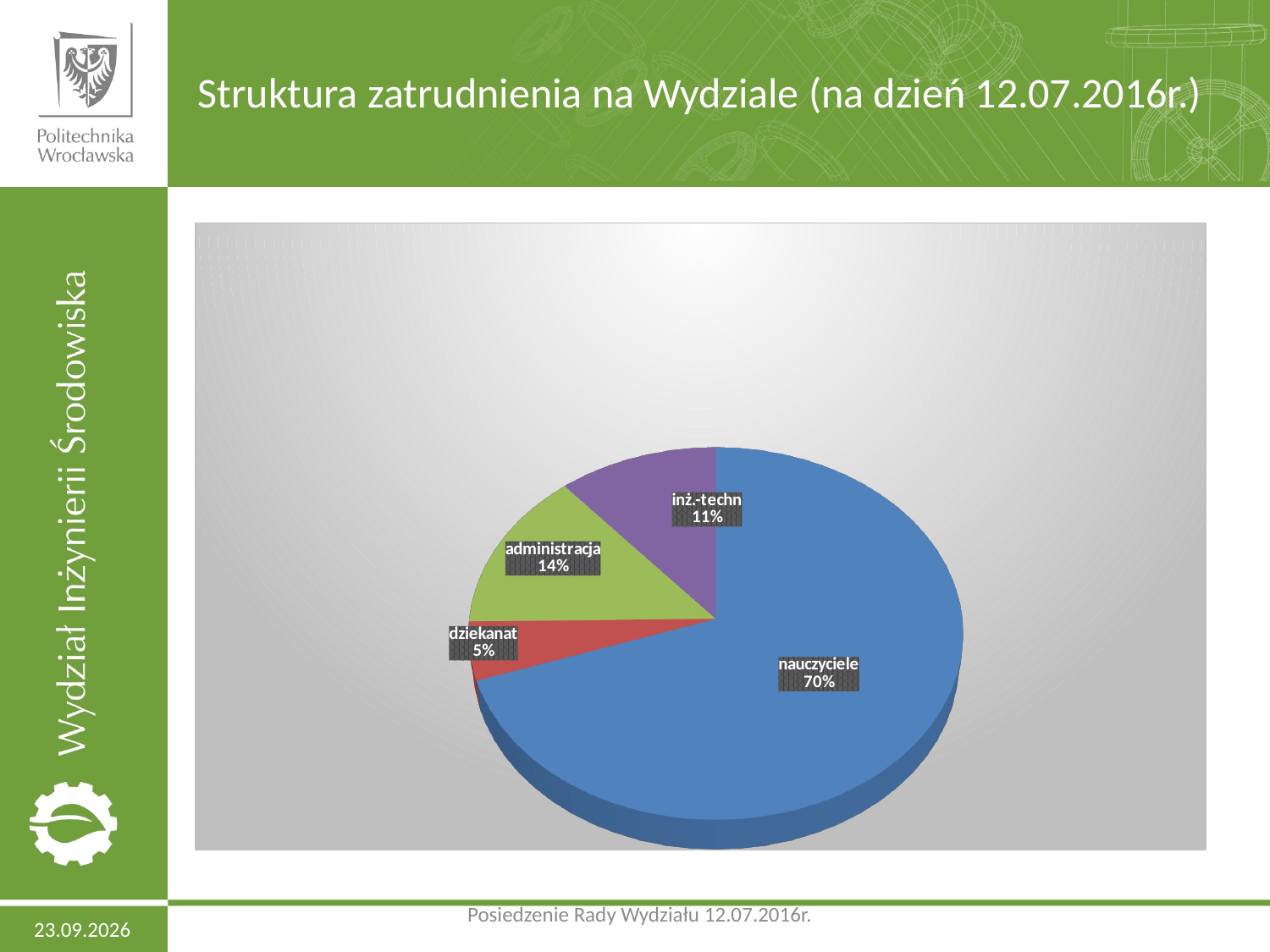
What share of the pie does the nauczyciele slice represent? 70% Which is larger, the share for administracja or the share for inż.-techn? administracja What is the difference in percentage points between the administracja and inż.-techn shares? 3 What colour is the nauczyciele slice? blue How many slices does the pie chart have? 4 Which category has the largest share of the pie? nauczyciele What kind of chart is shown on the slide? pie chart Which category has the smallest share of the pie? dziekanat What share of the pie does the inż.-techn slice represent? 11% What is the difference in percentage points between the nauczyciele and administracja shares? 56 What share of the pie does the administracja slice represent? 14%